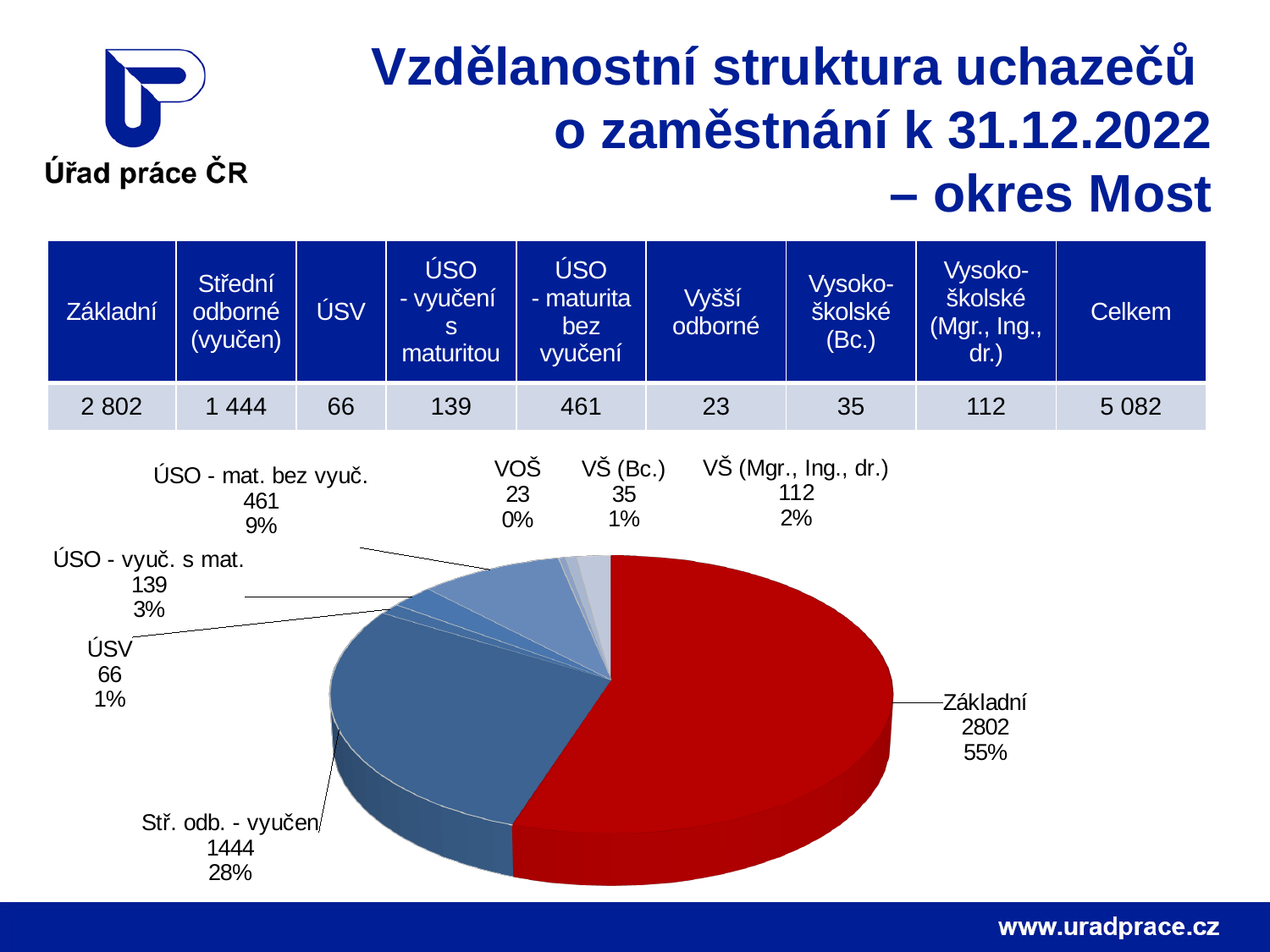
How many slices does the pie chart have? 8 Which category has the smallest slice in the pie chart? VOŠ What percentage share does the Základní slice have in the pie chart? 55% What is the value shown for the ÚSO - mat. bez vyuč. slice? 461 Which category has the largest slice in the pie chart? Základní What type of chart is shown on the slide? pie chart What is the value shown for the VŠ (Bc.) slice? 35 What percentage share does the Stř. odb. - vyučen slice have in the pie chart? 28% What colour is the Základní slice in the pie chart? red What is the difference between the Základní value and the Stř. odb. - vyučen value in the pie chart? 1358 Which is larger in the pie chart: ÚSO - vyuč. s mat. or VŠ (Mgr., Ing., dr.)? ÚSO - vyuč. s mat. What is the value shown for the Základní slice of the pie chart? 2802